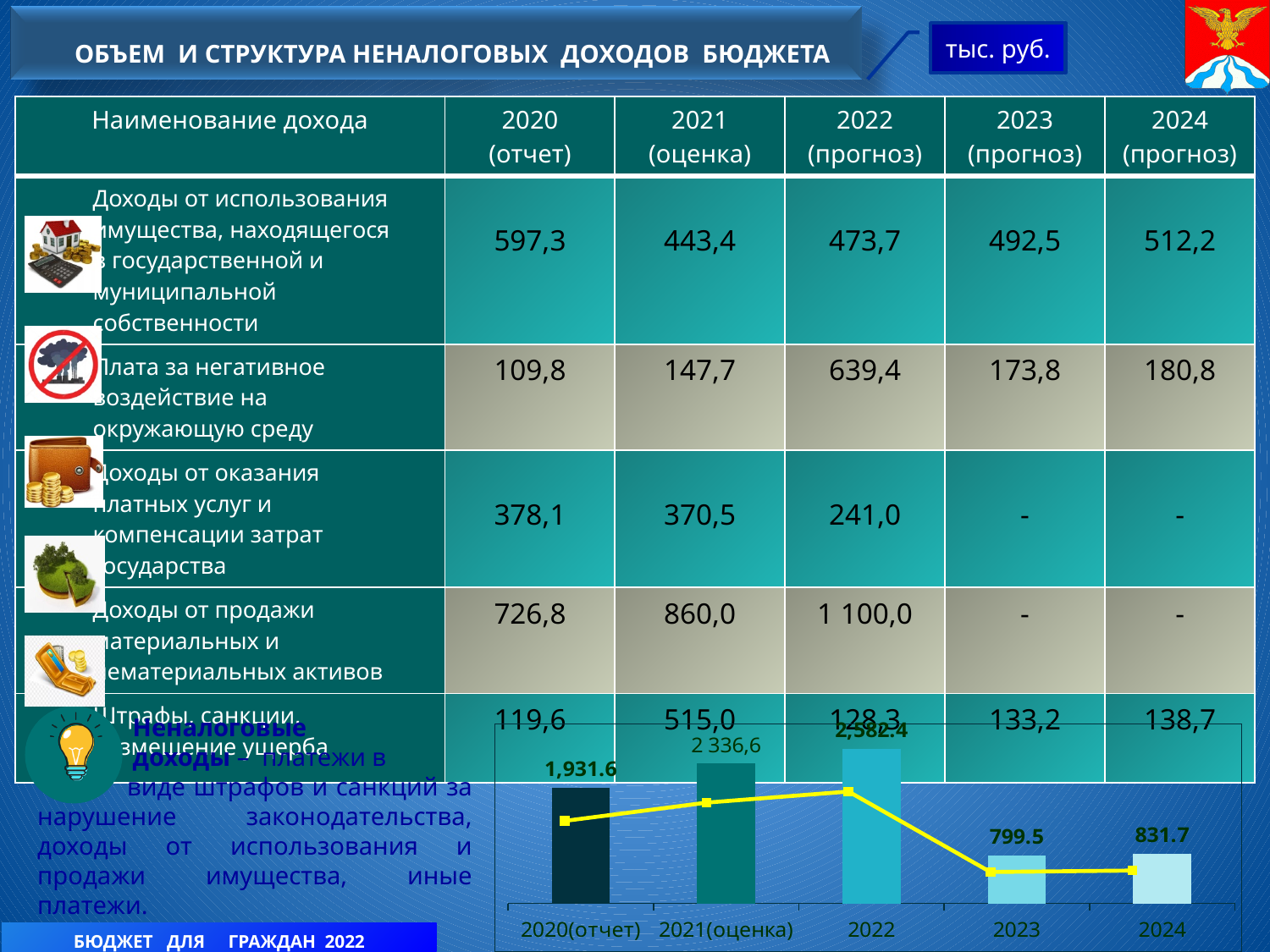
In the chart at the bottom of the slide, what is the value for 2020(отчет)? 1,931.6 In the chart at the bottom of the slide, how do the values change from 2022 to 2023? they fall sharply How many categories (years) are shown on the x axis of the chart at the bottom of the slide? 5 In the chart at the bottom of the slide, what is the value for 2024? 831.7 In the chart at the bottom of the slide, which year has the highest value? 2022 In the chart at the bottom of the slide, what is the difference between the values for 2024 and 2023? 32.2 In the chart at the bottom of the slide, what is the value for 2022? 2,582.4 In the chart at the bottom of the slide, which is larger: the value for 2020(отчет) or for 2021(оценка)? 2021(оценка) In the chart at the bottom of the slide, what is the value for 2023? 799.5 In the chart at the bottom of the slide, which year has the lowest value? 2023 In the chart at the bottom of the slide, what is the value for 2021(оценка)? 2 336,6 What kind of chart is shown at the bottom of the slide? bar chart with a line